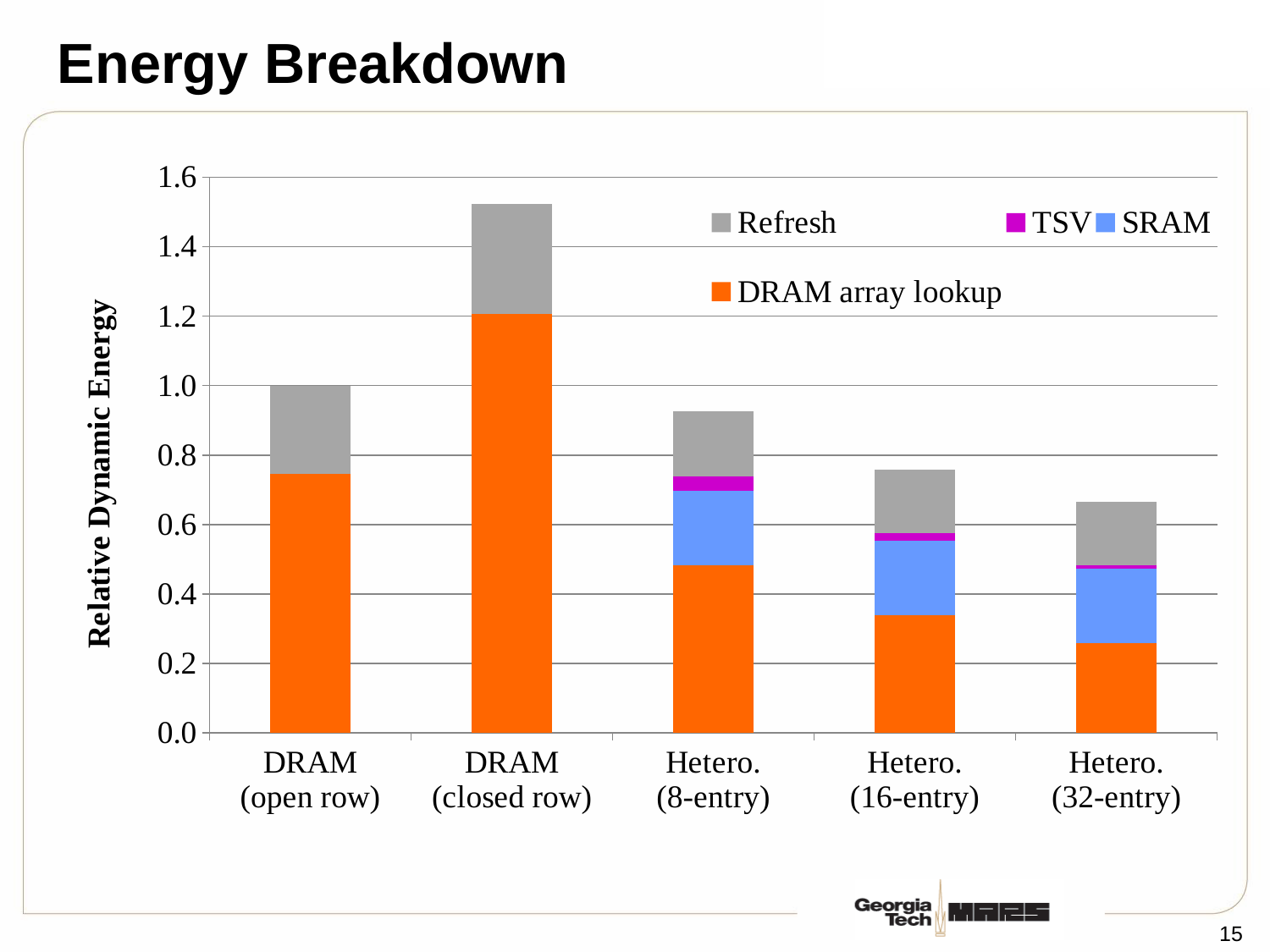
Which has a larger total relative dynamic energy, DRAM (open row) or Hetero. (8-entry)? DRAM (open row) What is the title of the y axis? Relative Dynamic Energy What kind of chart is shown on the slide? Stacked bar chart Do the total values rise or fall across the three Hetero. categories from 8-entry to 32-entry? fall Which category has the highest total relative dynamic energy? DRAM (closed row) Is the total value for Hetero. (32-entry) greater or less than 0.8? less Is the total value for DRAM (closed row) greater or less than 1.4? greater What is the total relative dynamic energy for DRAM (open row)? 1.0 Is the DRAM array lookup value for Hetero. (8-entry) greater or less than 0.6? less How many categories are plotted along the x axis? 5 Which category has the lowest total relative dynamic energy? Hetero. (32-entry) How many series does the legend list? 4